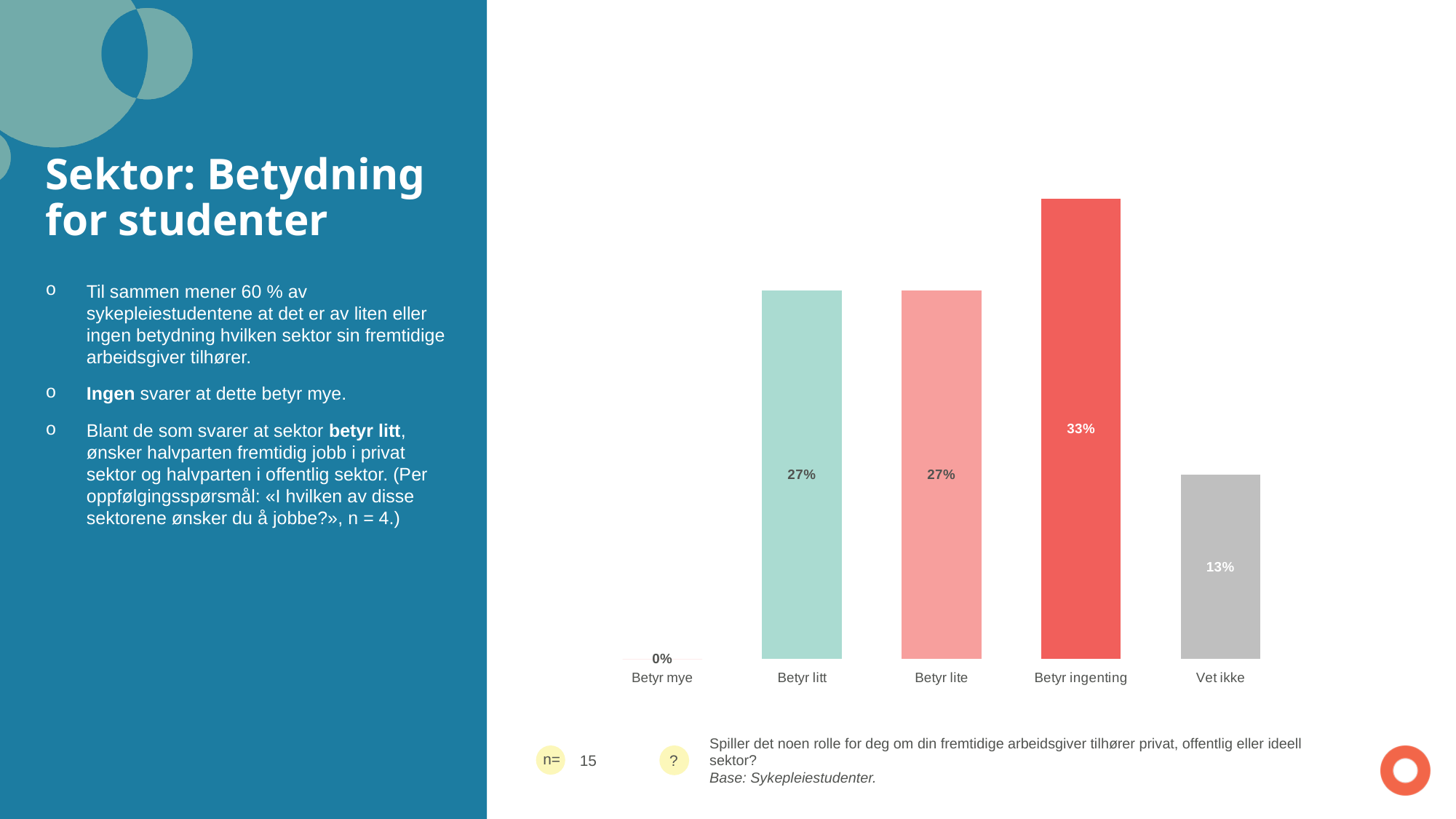
Which category has the highest value? Betyr ingenting What is the difference between the values for "Betyr ingenting" and "Vet ikke"? 20% Which is larger, the value for "Betyr lite" or the value for "Vet ikke"? Betyr lite What is the value for "Betyr mye"? 0% What is the n (number of respondents) shown below the chart? 15 What is the value for "Betyr ingenting"? 33% What is the value for "Betyr litt"? 27% What is the difference between the values for "Betyr litt" and "Vet ikke"? 14% What kind of chart is shown on the slide? Bar chart How many categories are shown on the chart? 5 Which category has the lowest value? Betyr mye What is the value for "Vet ikke"? 13%